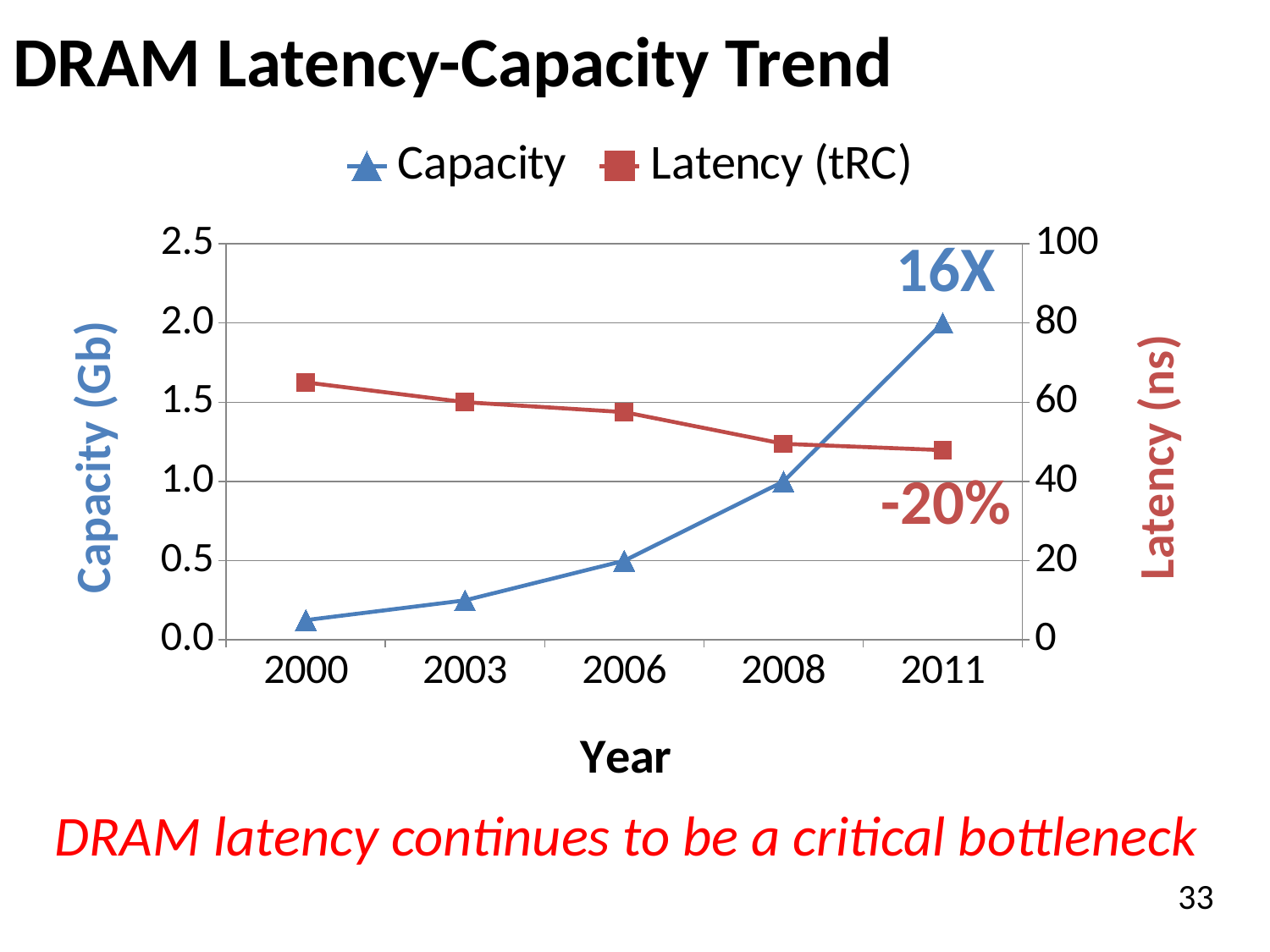
Is the Capacity value for 2000 greater or less than 0.5? less Is the Latency (tRC) value for 2011 greater or less than 60? less What is the Capacity value for 2011? 2.0 What is the Capacity value for 2006? 0.5 How many series does the legend list? 2 What is the label of the right-hand vertical axis? Latency (ns) Is the Latency (tRC) value for 2000 greater or less than 60? greater Does Capacity rise or fall from 2000 to 2011? rise What kind of chart is shown on the slide? line chart In which year is Latency (tRC) highest? 2000 What is the Capacity value for 2008? 1.0 How many years are plotted along the x axis? 5